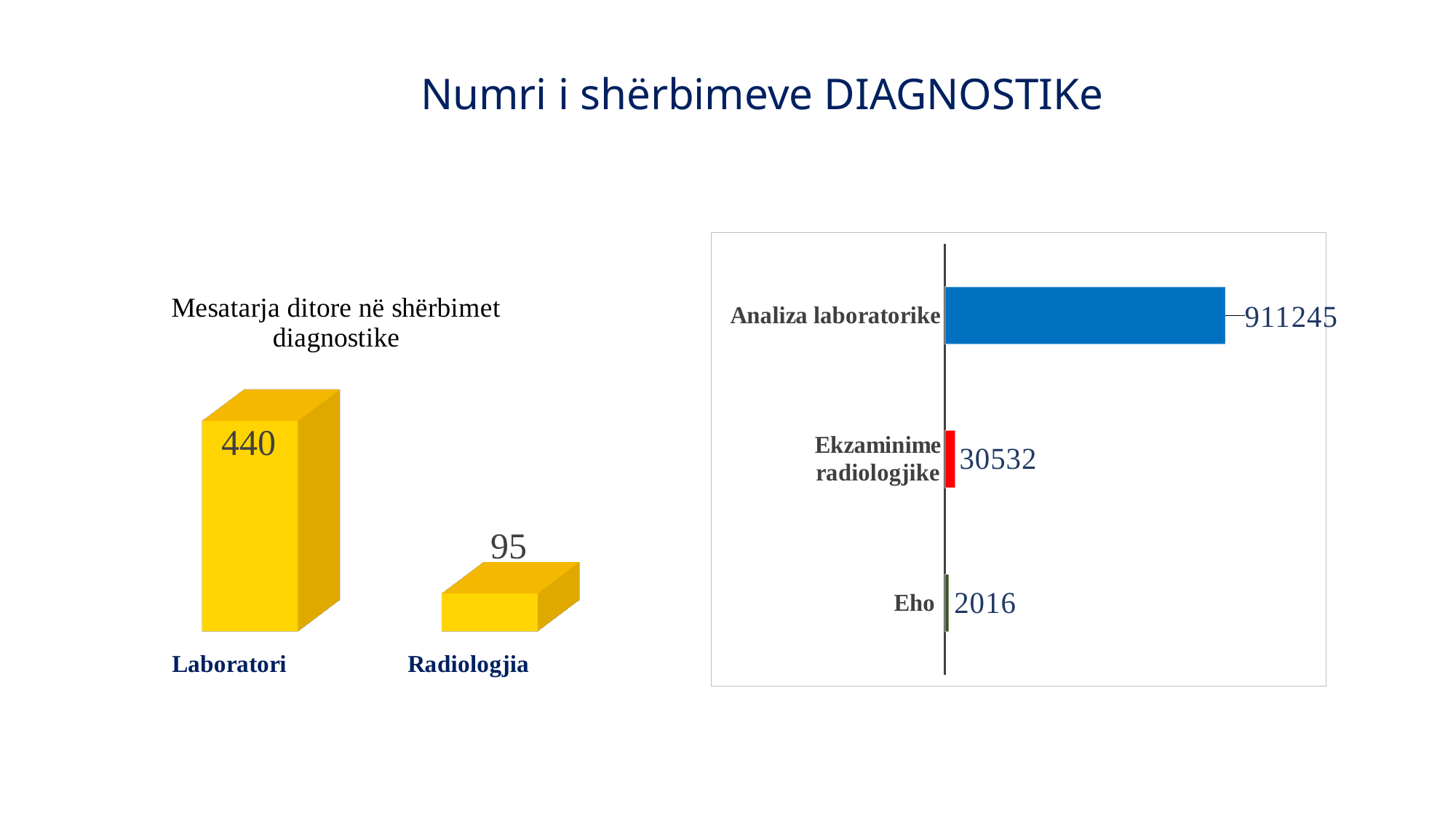
In the left chart titled 'Mesatarja ditore në shërbimet diagnostike', what is the value for Radiologjia? 95 In the left chart titled 'Mesatarja ditore në shërbimet diagnostike', which category has the highest value? Laboratori In the left chart titled 'Mesatarja ditore në shërbimet diagnostike', what is the value for Laboratori? 440 In the right chart, which category has the lowest value? Eho What kind of chart is the left chart titled 'Mesatarja ditore në shërbimet diagnostike'? Bar chart In the right chart, what is the value for Ekzaminime radiologjike? 30532 In the right chart, how many categories are shown? 3 In the left chart titled 'Mesatarja ditore në shërbimet diagnostike', what is the difference between Laboratori and Radiologjia? 345 In the right chart, what colour is the bar for Ekzaminime radiologjike? Red In the left chart titled 'Mesatarja ditore në shërbimet diagnostike', how many categories are shown? 2 In the right chart, what is the value for Analiza laboratorike? 911245 In the right chart, what is the value for Eho? 2016